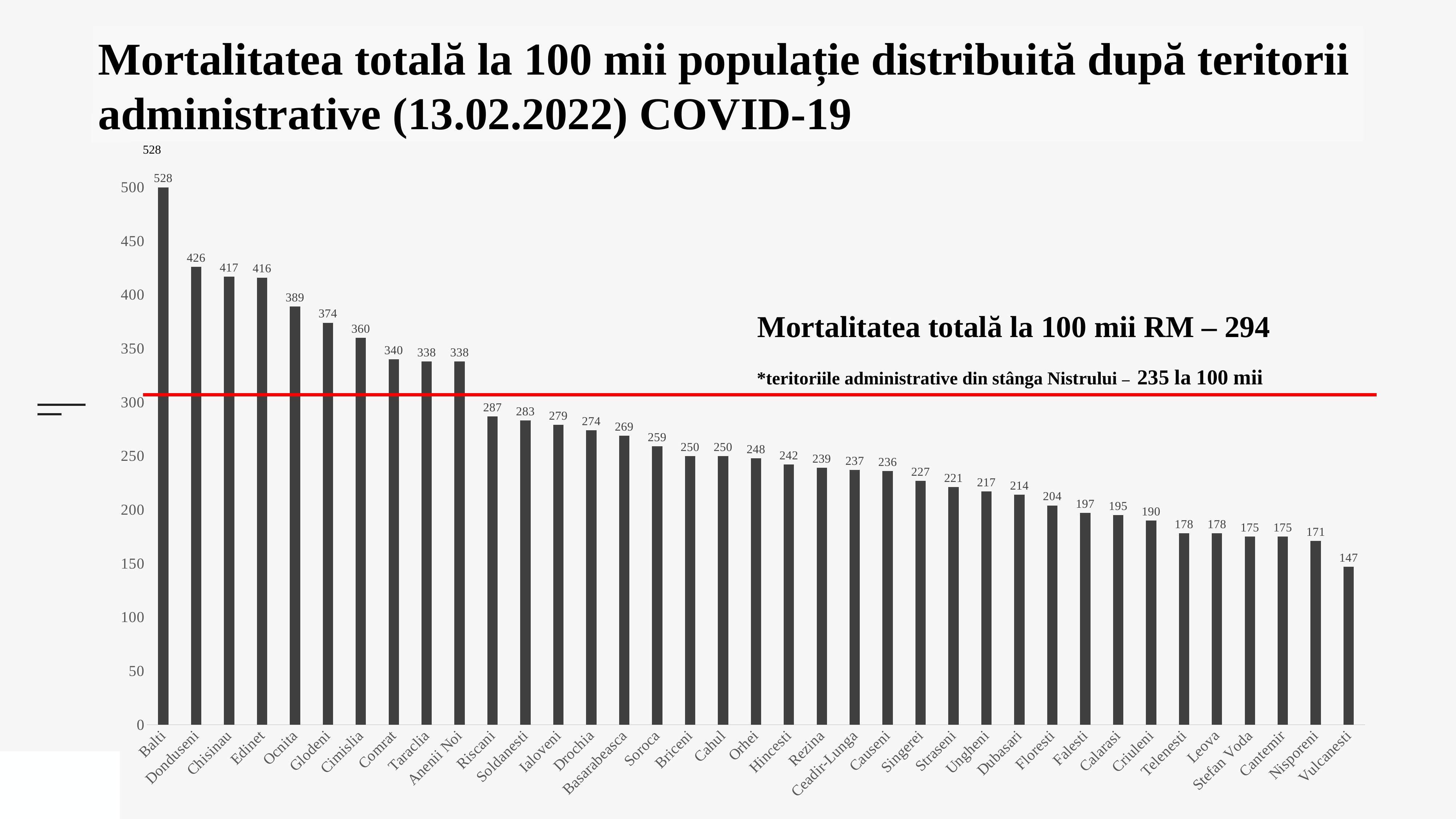
What is the difference between the values for Balti and Donduseni? 102 What is the value for Ungheni? 217 What kind of chart is shown on the slide? bar chart Do the values rise or fall from left to right along the x axis? fall What is the difference between the values for Cahul and Vulcanesti? 103 Which territory has the lowest value? Vulcanesti What is the value for Soroca? 259 Which territory has the highest value? Balti Which has a larger value, Ocnita or Comrat? Ocnita What is the value for Chisinau? 417 How many territories are shown on the x axis? 37 Is the value for Riscani greater or less than 300? less